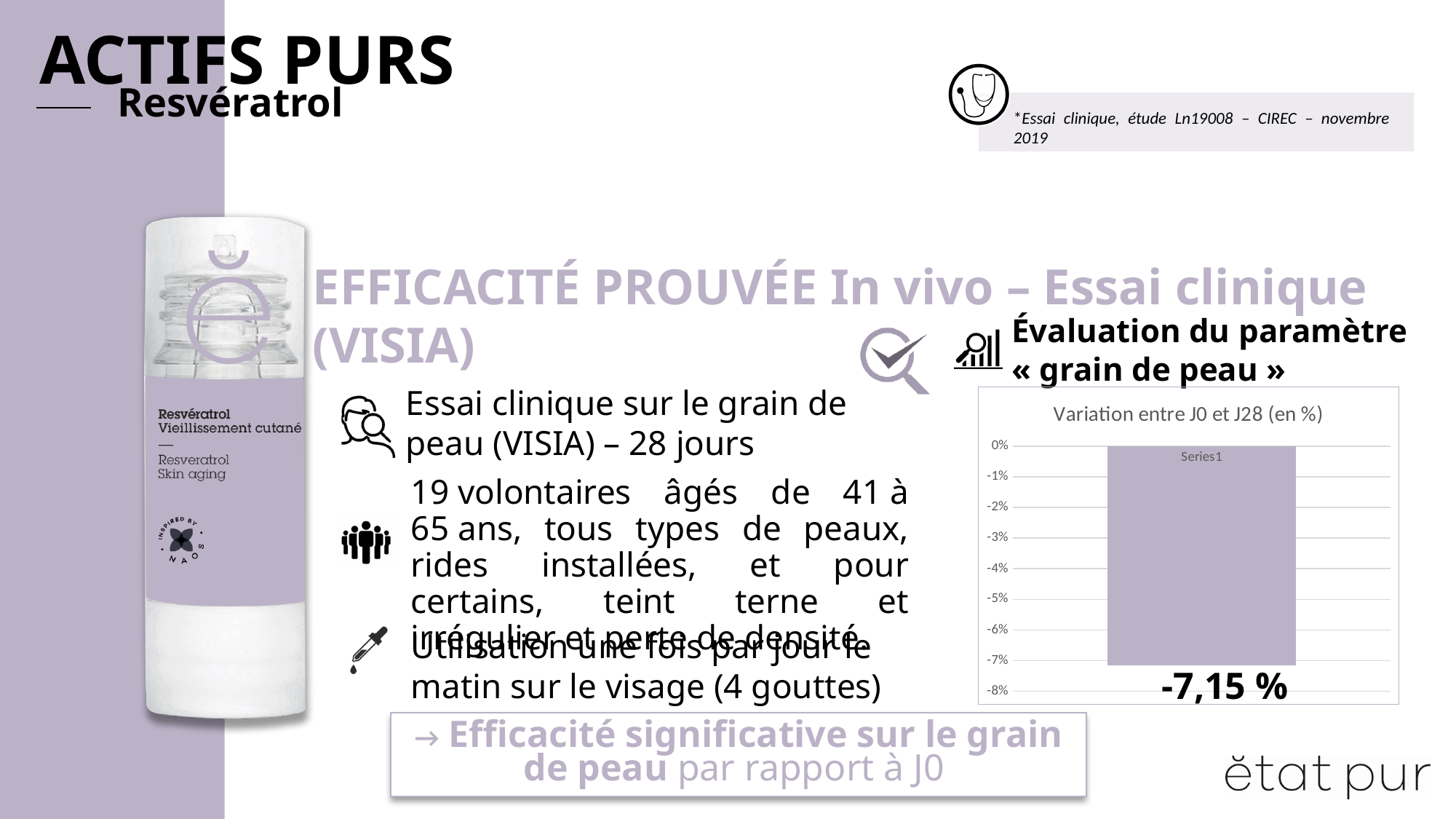
Is the value of the bar in the chart "Variation entre J0 et J28 (en %)" greater or less than -5%? less What is the name of the series shown on the bar in the chart? Series1 What is the lowest tick value shown on the vertical axis of the chart? -8% How many bars are plotted in the chart "Variation entre J0 et J28 (en %)"? 1 What is the title of the chart on the slide? Variation entre J0 et J28 (en %) Is the value of the bar in the chart "Variation entre J0 et J28 (en %)" greater or less than -8%? greater What value is printed on the bar in the chart "Variation entre J0 et J28 (en %)"? -7,15 % What kind of chart is shown under "Évaluation du paramètre « grain de peau »"? bar chart